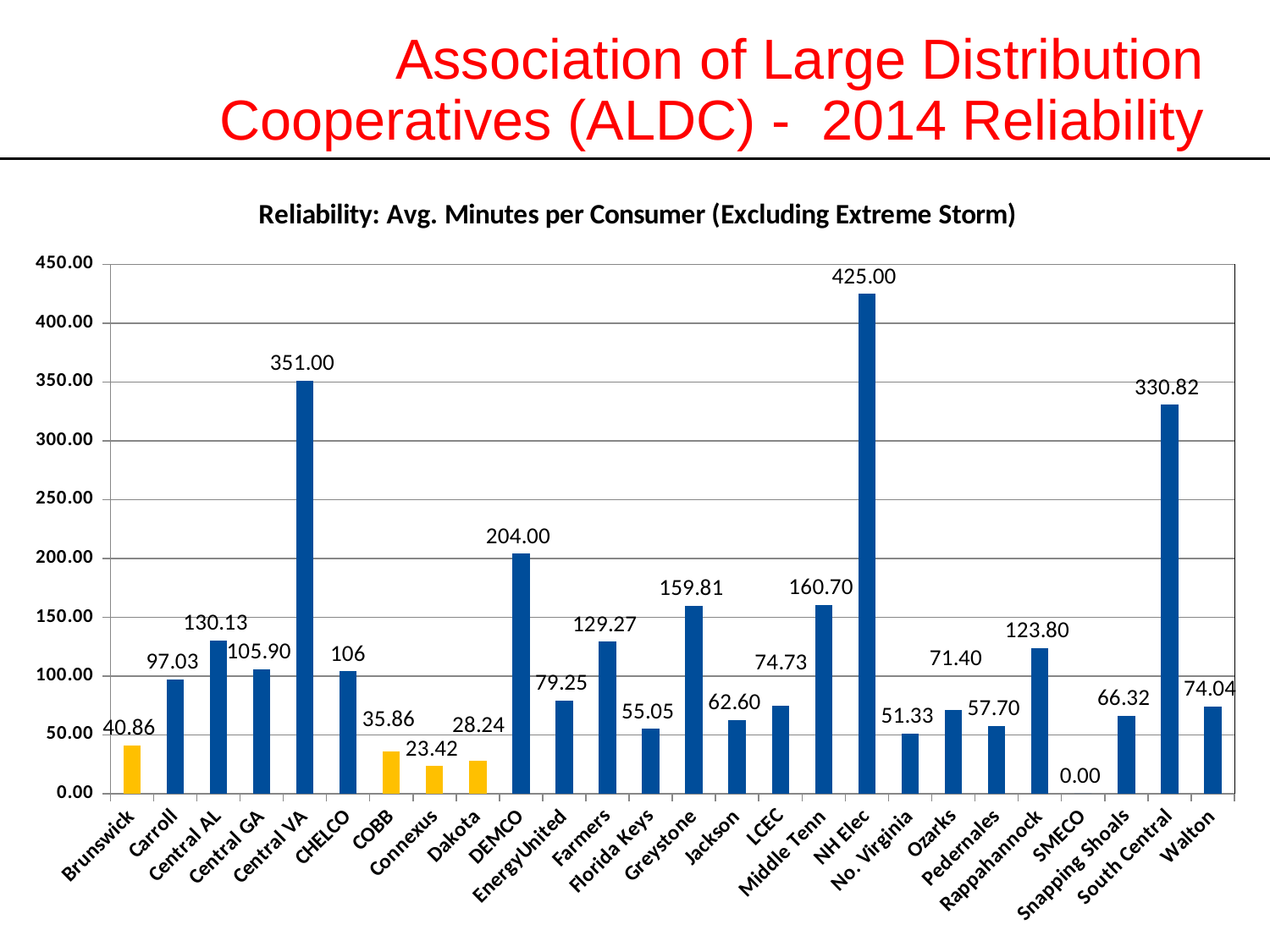
What is the title of the chart? Reliability: Avg. Minutes per Consumer (Excluding Extreme Storm) How many cooperatives are shown on the x axis? 26 What is the value for CHELCO? 106 What is the difference between the values for NH Elec and Central VA? 74.00 Is the value for Rappahannock greater or less than 100? greater Which cooperative has the highest average minutes per consumer? NH Elec What is the value for NH Elec? 425.00 What is the value for Rappahannock? 123.80 Which cooperative has the lowest average minutes per consumer? SMECO What is the difference between the values for DEMCO and Greystone? 44.19 What is the value for Central VA? 351.00 Which is larger, the value for Central VA or the value for South Central? Central VA